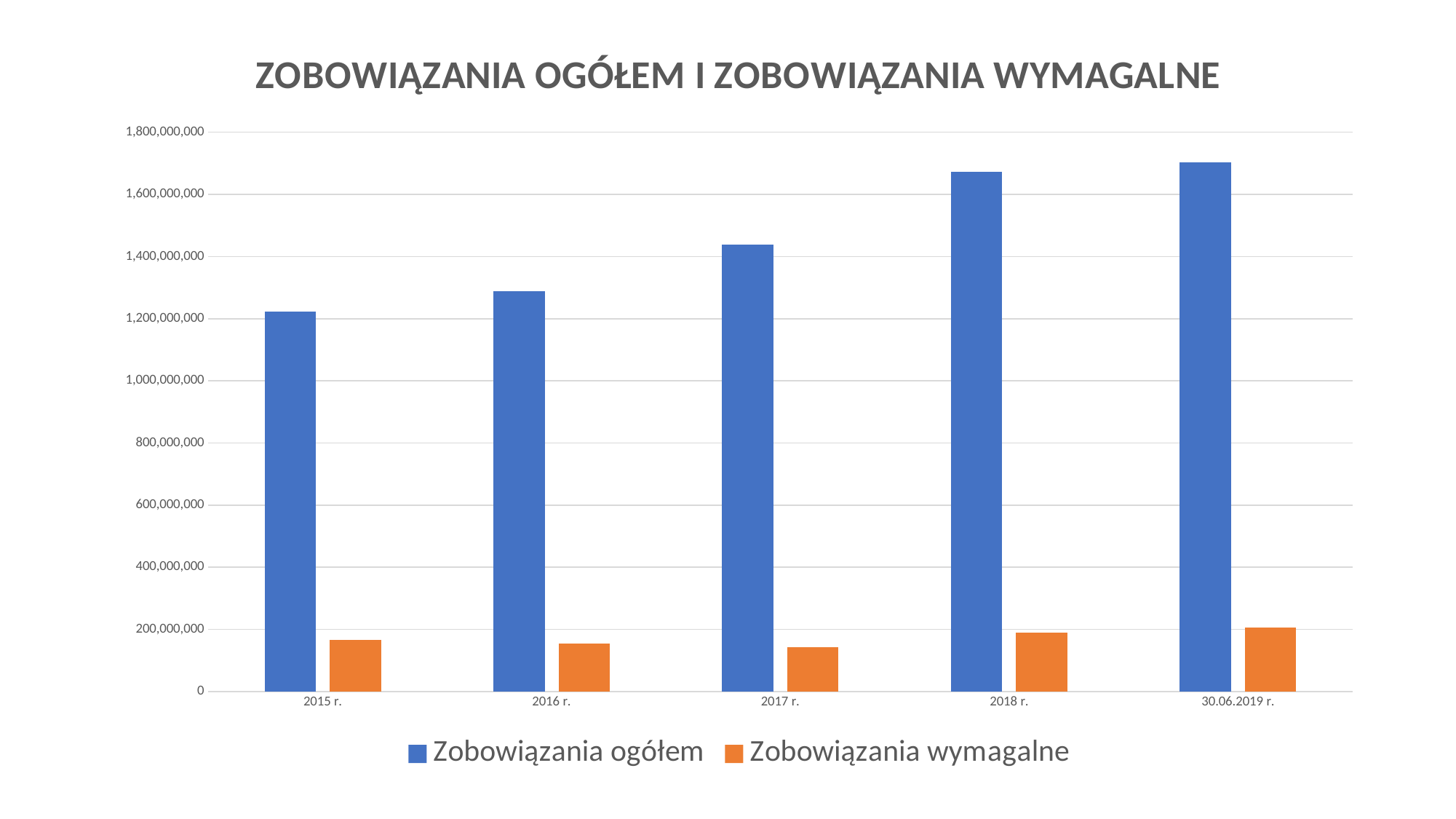
Is the value for Zobowiązania wymagalne in 2016 r. greater or less than 200,000,000? less Is the value for Zobowiązania ogółem in 2018 r. greater or less than 1,600,000,000? greater Which category has the highest value for Zobowiązania wymagalne? 30.06.2019 r. Which is larger: Zobowiązania ogółem in 2016 r. or Zobowiązania ogółem in 2017 r.? 2017 r. Which category has the lowest value for Zobowiązania ogółem? 2015 r. Which category has the lowest value for Zobowiązania wymagalne? 2017 r. What kind of chart is shown on the slide? bar chart Which category has the highest value for Zobowiązania ogółem? 30.06.2019 r. How many series does the legend list? 2 How many categories are shown on the x axis? 5 Is the value for Zobowiązania ogółem in 2017 r. greater or less than 1,400,000,000? greater Do the values for Zobowiązania ogółem rise or fall from 2015 r. to 30.06.2019 r.? rise